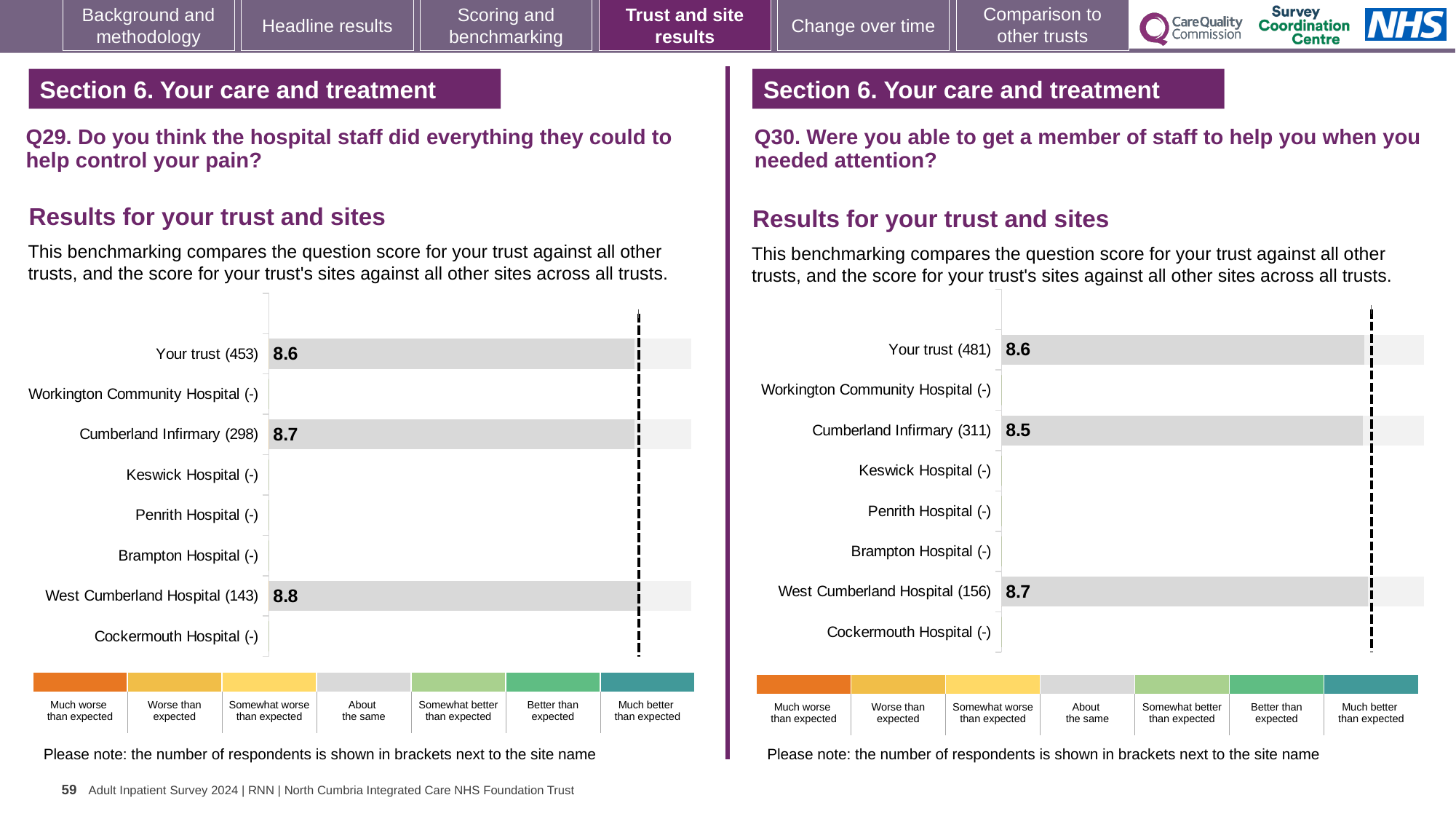
In the Q30 chart (right), how many respondents are shown in brackets for Your trust? 481 In the Q29 chart (left), what is the score for West Cumberland Hospital? 8.8 In the Q29 chart (left), which is larger: the score for Cumberland Infirmary or the score for Your trust? Cumberland Infirmary In the Q30 chart (right), what is the score for Cumberland Infirmary? 8.5 In the Q30 chart (right), which site or trust row has the lowest printed score? Cumberland Infirmary In the Q29 chart (left), which site or trust row has the highest score? West Cumberland Hospital How many site or trust rows are listed on the Q29 chart (left)? 8 In the Q30 chart (right), what is the difference between the scores for West Cumberland Hospital and Cumberland Infirmary? 0.2 In the Q29 chart (left), what is the score for Your trust? 8.6 In the Q30 chart (right), what is the score for West Cumberland Hospital? 8.7 What kind of chart is used for the Q30 results (right)? Bar chart In the Q29 chart (left), what is the score for Cumberland Infirmary? 8.7